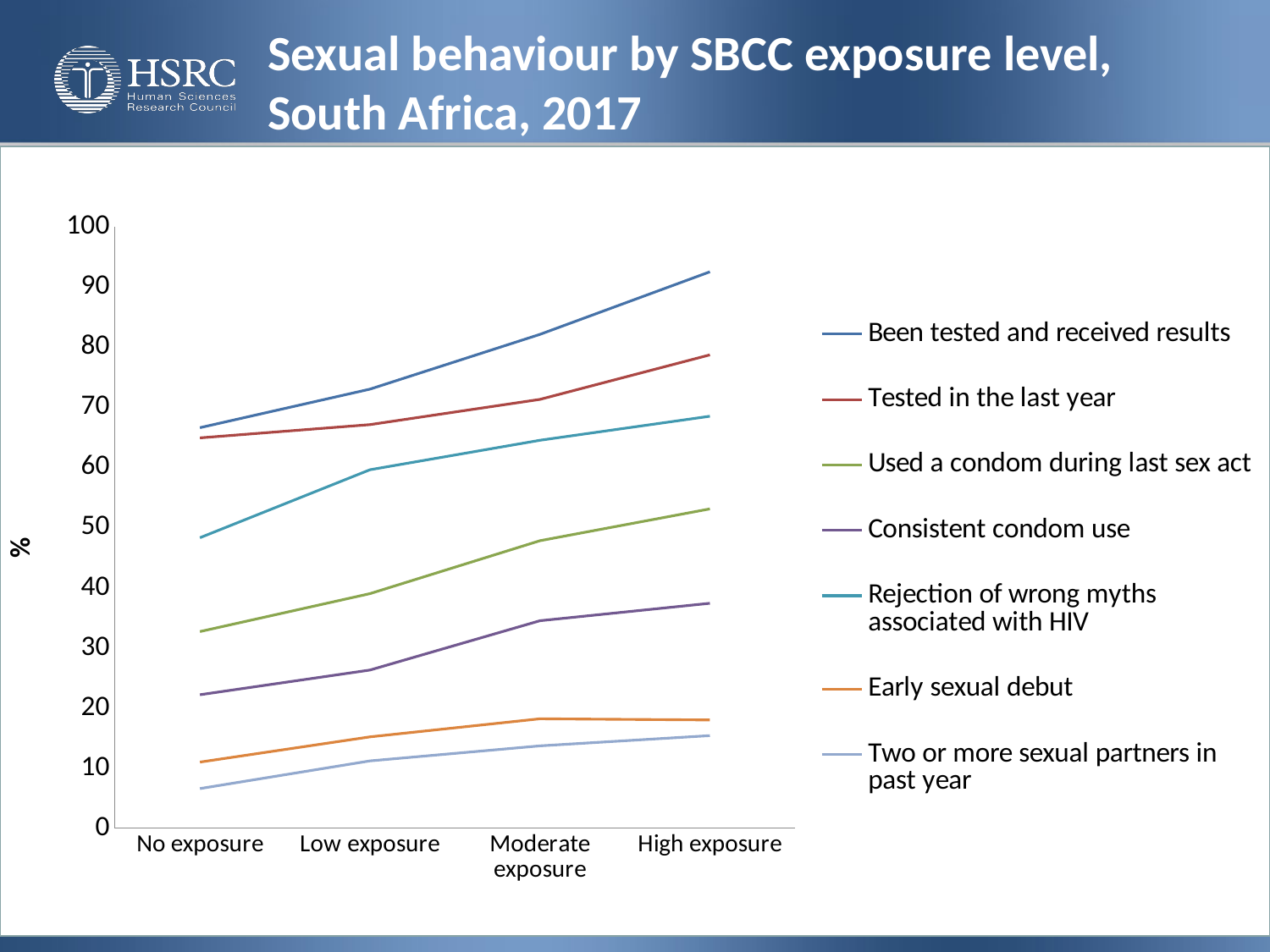
How many series does the legend list? 7 At Moderate exposure, which is larger: 'Tested in the last year' or 'Rejection of wrong myths associated with HIV'? Tested in the last year What is the label on the y axis? % Is the value for 'Consistent condom use' at High exposure greater or less than 40? less Is the value for 'Used a condom during last sex act' at No exposure greater or less than 40? less Which series has the highest value at High exposure? Been tested and received results Is the value for 'Been tested and received results' at High exposure greater or less than 80? greater Which series has the lowest value at No exposure? Two or more sexual partners in past year What kind of chart is shown on the slide? line chart Does the value for 'Been tested and received results' rise or fall as exposure level increases from No exposure to High exposure? rise How many exposure-level categories are shown on the x axis? 4